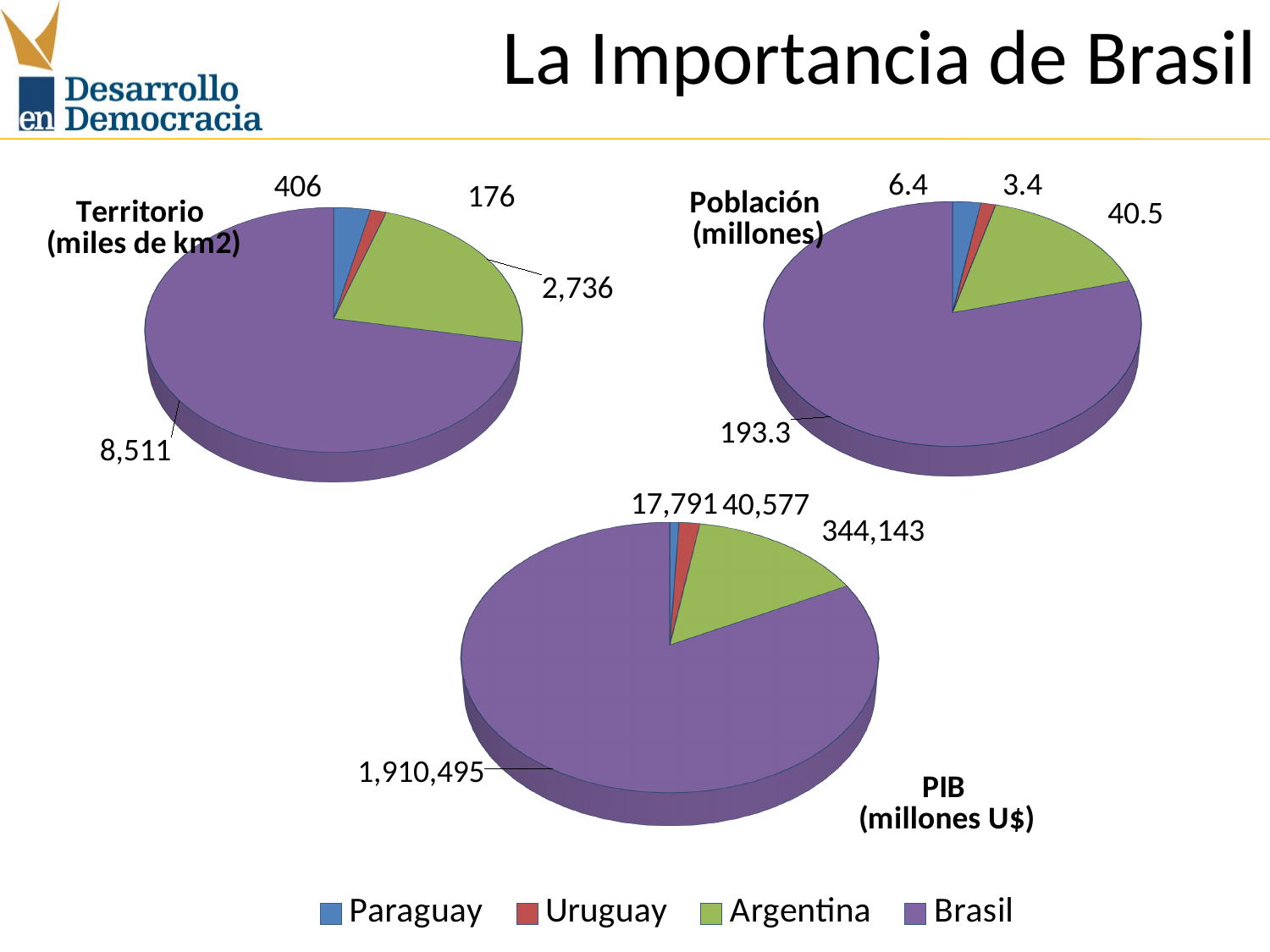
In the Territorio (miles de km2) chart, what is the difference between the values for Argentina and Paraguay? 2,330 In the Población (millones) chart, what is the value for Argentina? 40.5 What kind of chart is the Territorio (miles de km2) chart? pie chart In the Población (millones) chart, which country has the smallest slice? Uruguay Which colour represents Argentina in the pie charts? green In the Territorio (miles de km2) chart, what is the value for Uruguay? 176 In the Población (millones) chart, how much larger is the value for Brasil than the value for Argentina? 152.8 In the PIB (millones U$) chart, which is larger, the value for Uruguay or the value for Paraguay? Uruguay In the PIB (millones U$) chart, what is the value for Paraguay? 17,791 How many countries does the legend list? 4 In the PIB (millones U$) chart, which country has the largest slice? Brasil In the Territorio (miles de km2) chart, what is the value for Brasil? 8,511